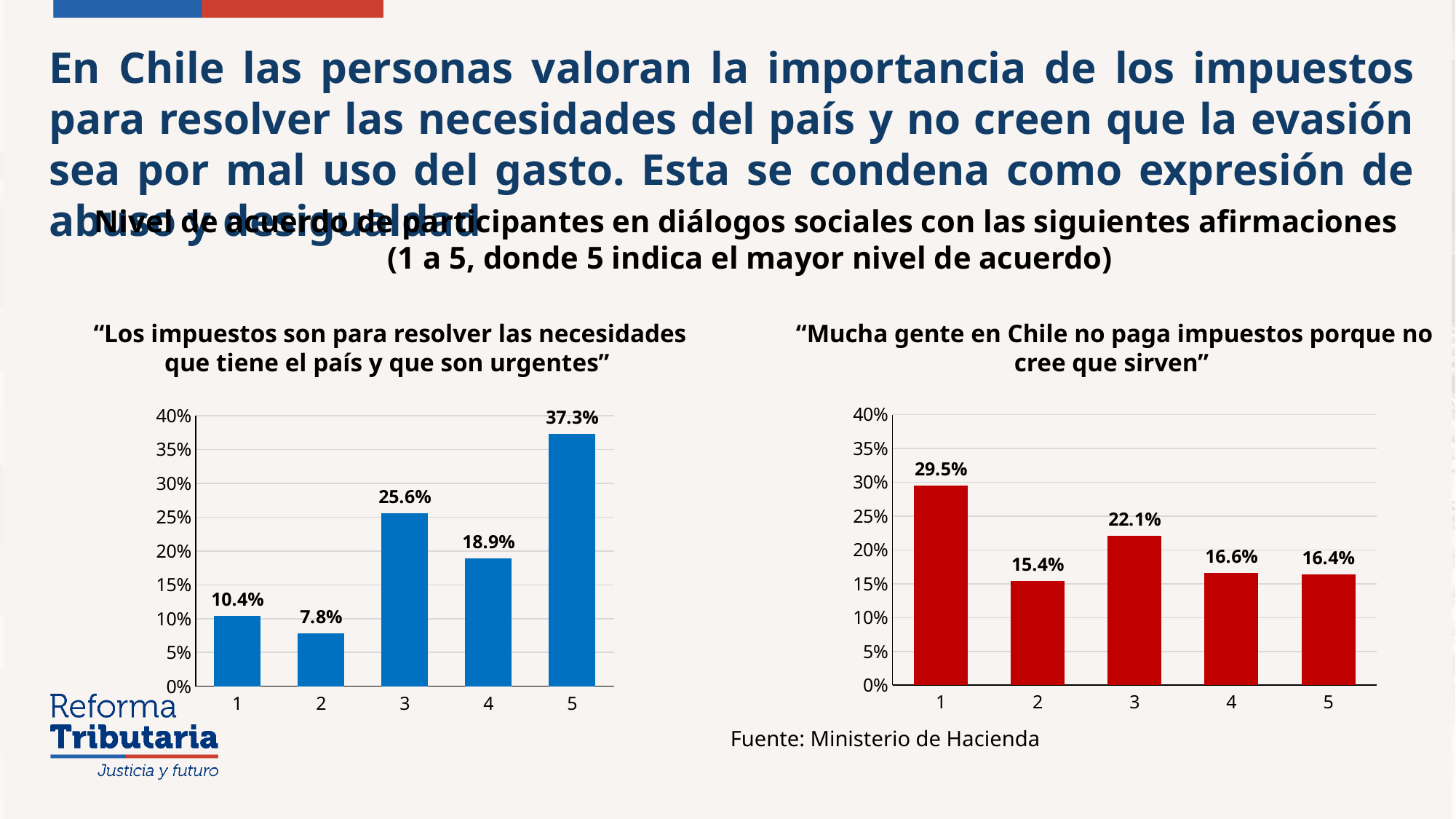
How many categories are shown on the x axis of the right chart ("Mucha gente en Chile no paga impuestos...")? 5 In the right chart ("Mucha gente en Chile no paga impuestos..."), what is the difference between the values for level 1 and level 2? 14.1% In the left chart ("Los impuestos son para resolver las necesidades..."), which is larger, the value for level 3 or the value for level 4? Level 3 In the left chart ("Los impuestos son para resolver las necesidades que tiene el país y que son urgentes"), what is the value for level 5? 37.3% What colour are the bars in the right chart ("Mucha gente en Chile no paga impuestos...")? Red In the right chart ("Mucha gente en Chile no paga impuestos..."), what is the value for level 3? 22.1% In the right chart ("Mucha gente en Chile no paga impuestos..."), which level has the lowest value? 2 In the left chart ("Los impuestos son para resolver las necesidades..."), what is the value for level 2? 7.8% In the left chart ("Los impuestos son para resolver las necesidades..."), which level has the highest value? 5 What kind of chart is the left chart ("Los impuestos son para resolver las necesidades...")? Bar chart In the left chart ("Los impuestos son para resolver las necesidades..."), what is the difference between the values for level 5 and level 3? 11.7% In the right chart ("Mucha gente en Chile no paga impuestos porque no cree que sirven"), what is the value for level 1? 29.5%